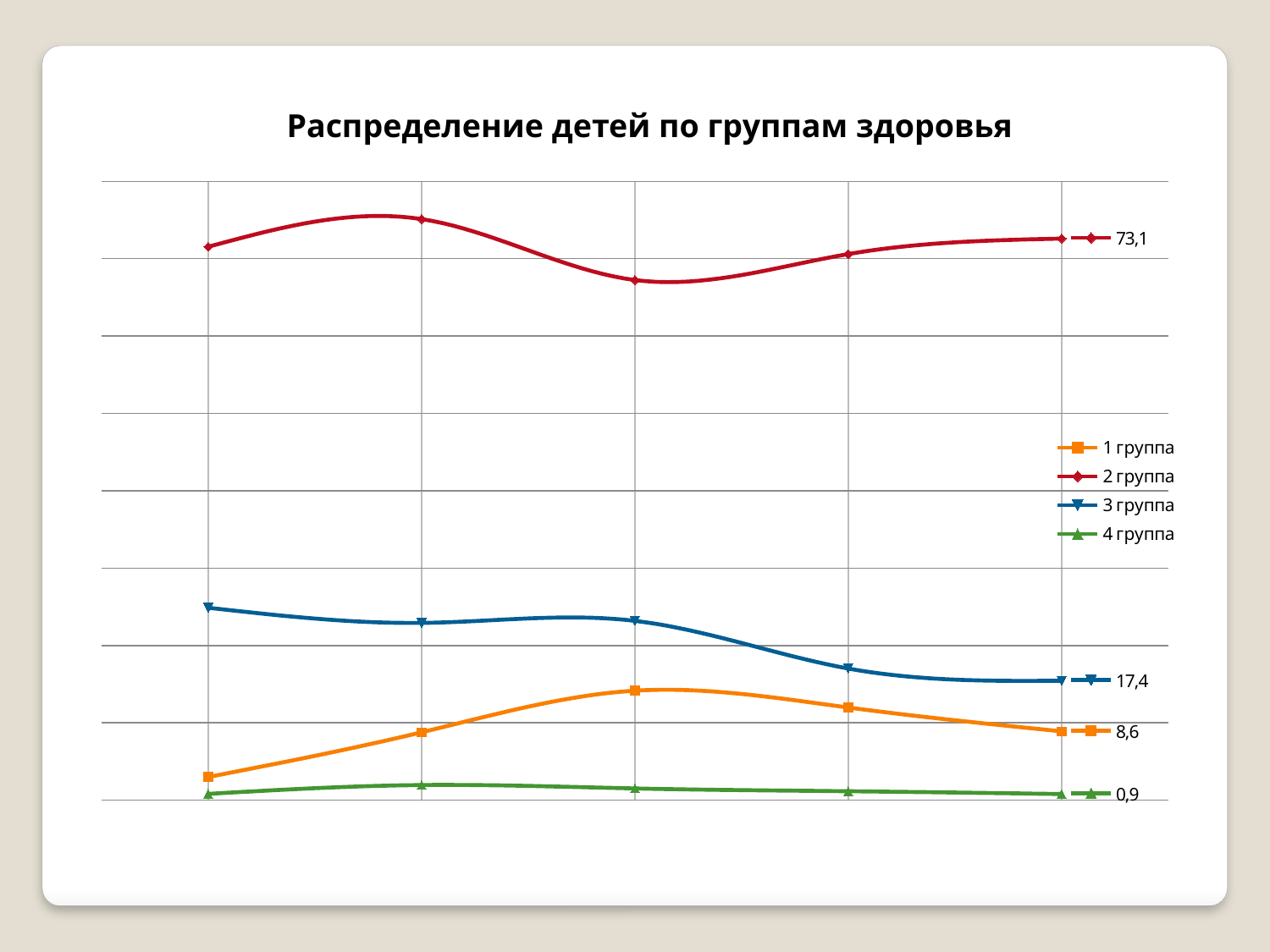
How many series does the legend list? 4 What is the labelled final value for 4 группа? 0,9 What is the labelled final value for 3 группа? 17,4 What kind of chart is shown on the slide? line chart Which series has the lowest value at the last point? 4 группа Which series has the highest value at the last point? 2 группа What is the title of the chart? Распределение детей по группам здоровья What is the difference between the final values of 2 группа and 3 группа? 55,7 What is the labelled final value for 1 группа? 8,6 How many data points does each line have? 5 Does the line for 3 группа rise or fall from its first point to its last point? fall What is the labelled final value for 2 группа? 73,1